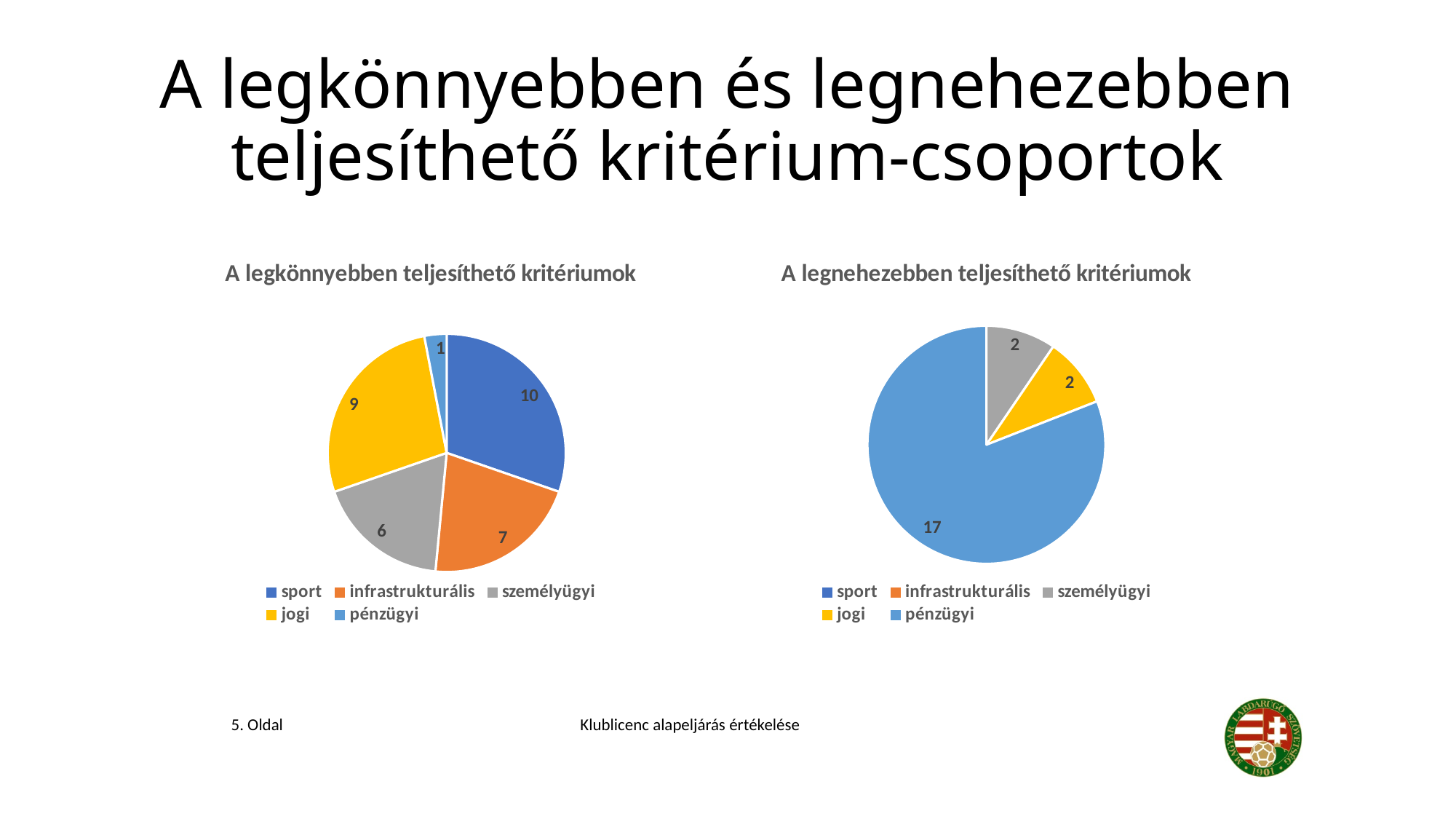
In the right pie chart, what is the difference between the values for pénzügyi and jogi? 15 In the left pie chart, which category has the largest slice? sport In the left pie chart, which is larger, infrastrukturális or jogi? jogi In the chart titled 'A legkönnyebben teljesíthető kritériumok', what is the value for sport? 10 What type of chart is used on this slide? Pie chart In the chart titled 'A legnehezebben teljesíthető kritériumok', what is the value for pénzügyi? 17 In the left pie chart, which category has the smallest slice? pénzügyi In the chart titled 'A legkönnyebben teljesíthető kritériumok', what is the value for jogi? 9 In the left pie chart, what is the difference between the values for sport and személyügyi? 4 In the chart titled 'A legkönnyebben teljesíthető kritériumok', what is the value for pénzügyi? 1 In the right pie chart, which category has the largest slice? pénzügyi How many entries does the legend of the left chart list? 5